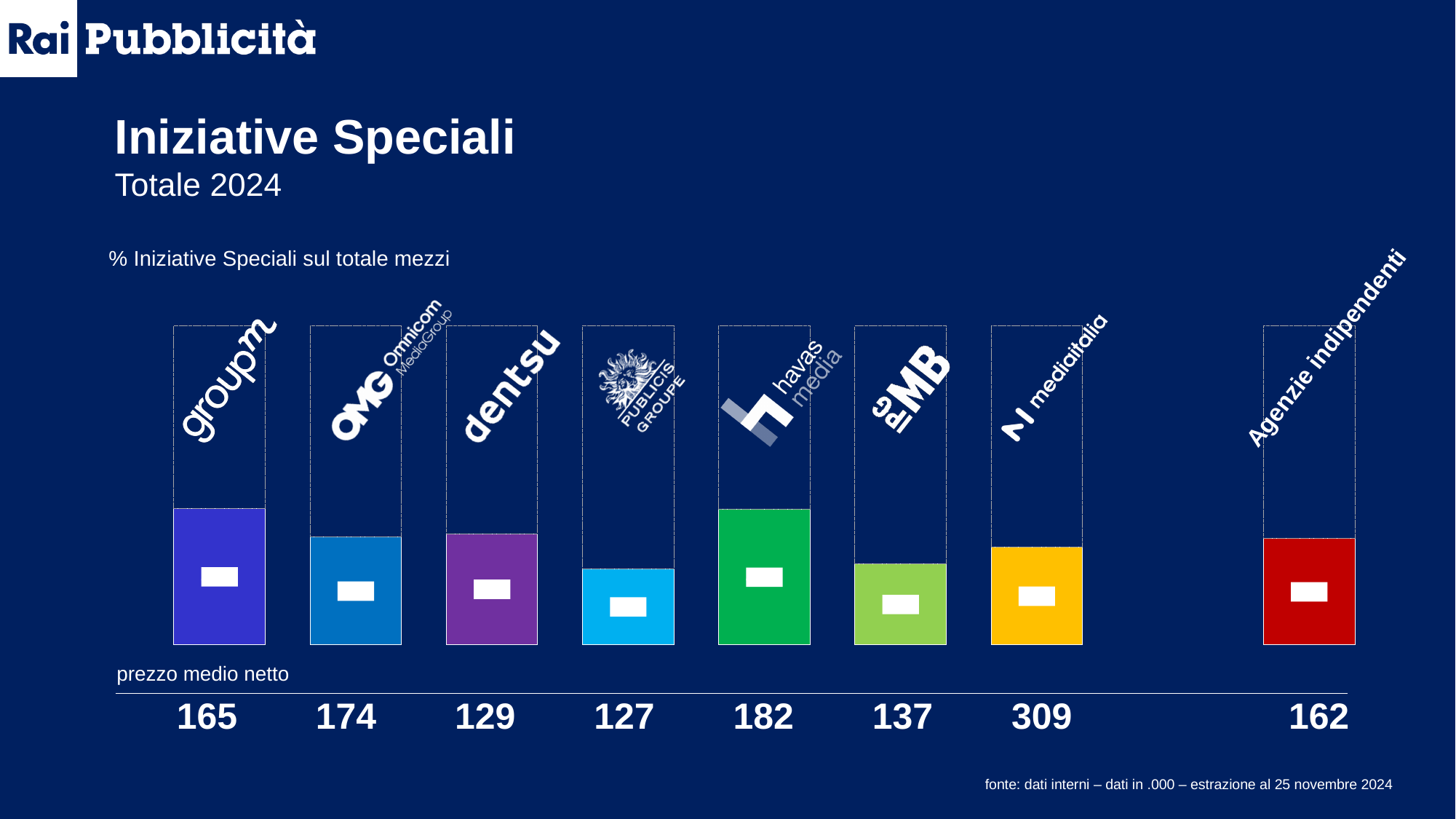
How many agency categories (bars) are shown in the chart? 8 What is the prezzo medio netto shown for Agenzie indipendenti? 162 What is the prezzo medio netto shown for GroupM? 165 Which agency has the lowest prezzo medio netto? Publicis Groupe What is the title of the slide containing the chart? Iniziative Speciali What is the prezzo medio netto shown for Dentsu? 129 Which has a higher prezzo medio netto, Omnicom Media Group or GroupM? Omnicom Media Group Which agency has the highest prezzo medio netto? Mediaitalia What is the prezzo medio netto shown for Havas Media? 182 Which bar is taller in the chart, Dentsu or Publicis Groupe? Dentsu What is the difference between the prezzo medio netto of Mediaitalia and that of Publicis Groupe? 182 What kind of chart is shown on the slide? bar chart